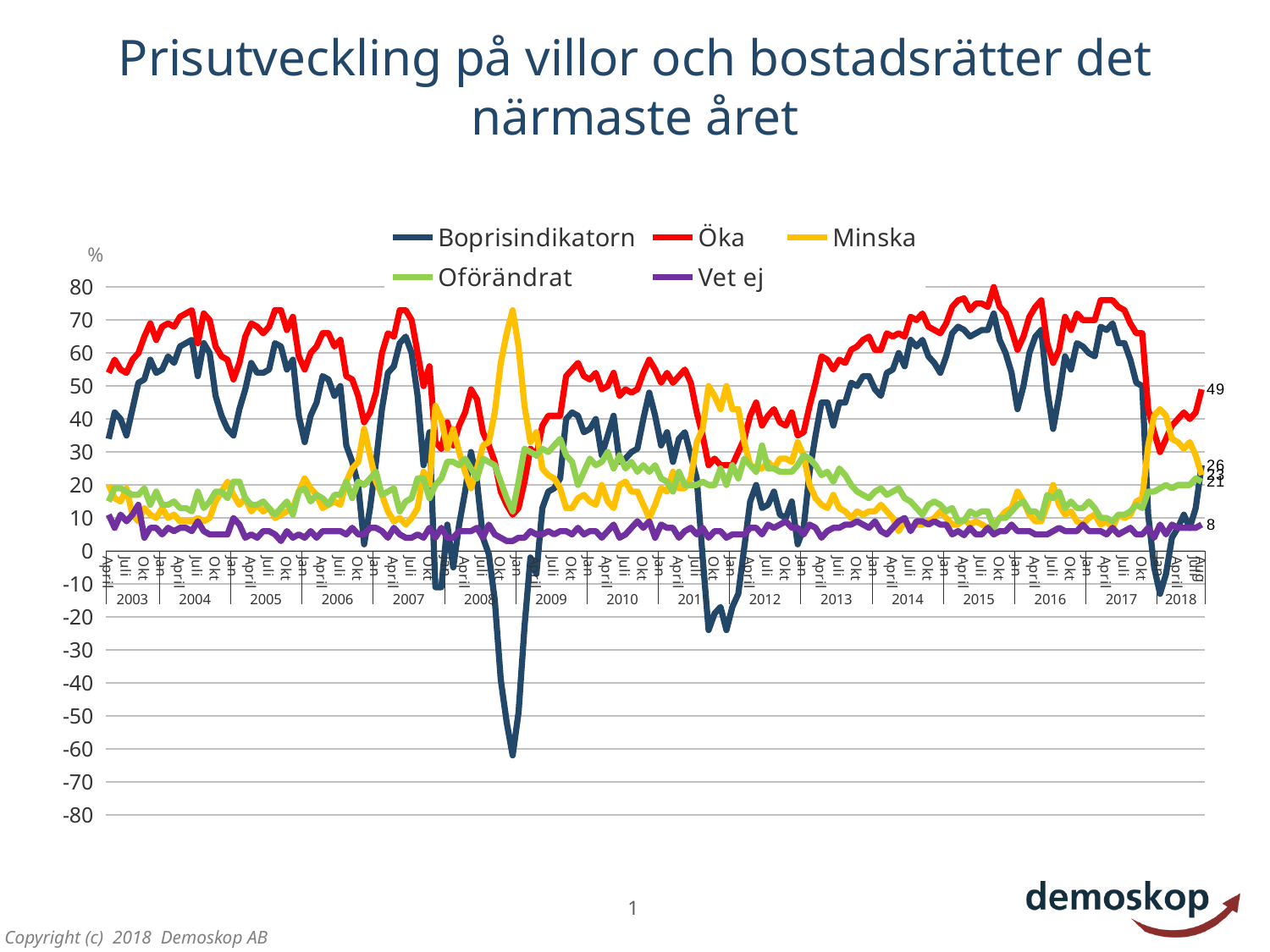
Which series has the highest value at the right end of the chart? Öka Is the peak value of Öka in 2015 greater or less than 70? greater What kind of chart is shown on the slide? line chart At the right end of the chart, which is larger: Öka or Minska? Öka What is the final labelled value of the Öka series? 49 What is the title of the chart? Prisutveckling på villor och bostadsrätter det närmaste året Is the lowest value of Boprisindikatorn around the start of 2009 greater or less than -50? less What is the final labelled value of the Vet ej series? 8 Which series has the lowest value at the right end of the chart? Vet ej Which series is drawn in red? Öka What is the difference between the final labelled values of Öka (49) and Vet ej (8)? 41 How many series does the legend list? 5